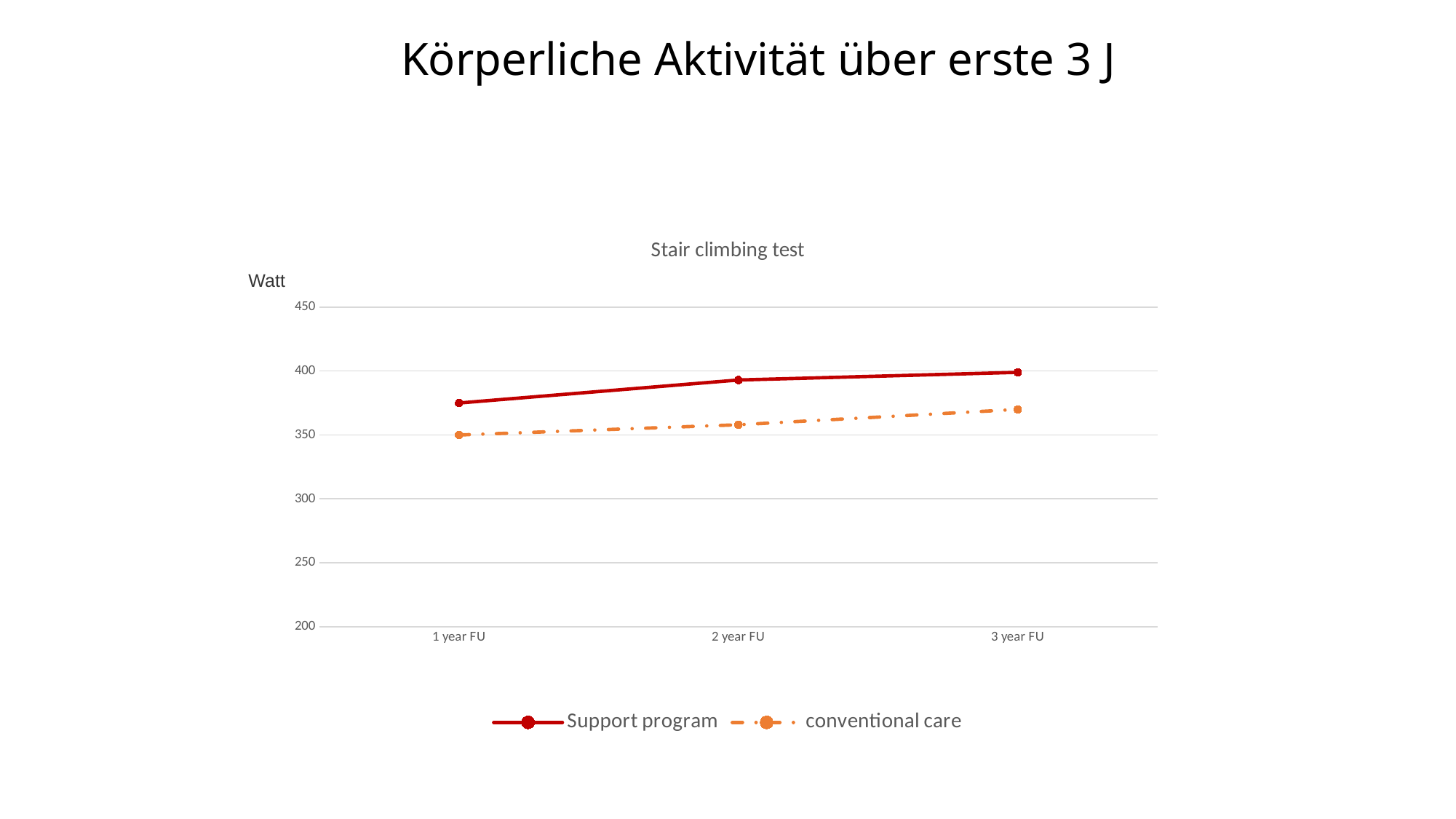
Is the value for Support program at 1 year FU greater or less than 400? less What kind of chart is shown on the slide? line chart Which series has the higher value at 3 year FU, Support program or conventional care? Support program How many series does the legend list? 2 How many follow-up time points are plotted along the x axis? 3 Is the value for conventional care at 3 year FU greater or less than 400? less What is the title of the chart? Stair climbing test What unit is shown on the y axis? Watt Do the values for Support program rise or fall from 1 year FU to 3 year FU? rise Is the value for Support program at 2 year FU greater or less than 350? greater At which time point is the value for conventional care lowest? 1 year FU Do the values for conventional care rise or fall from 1 year FU to 3 year FU? rise